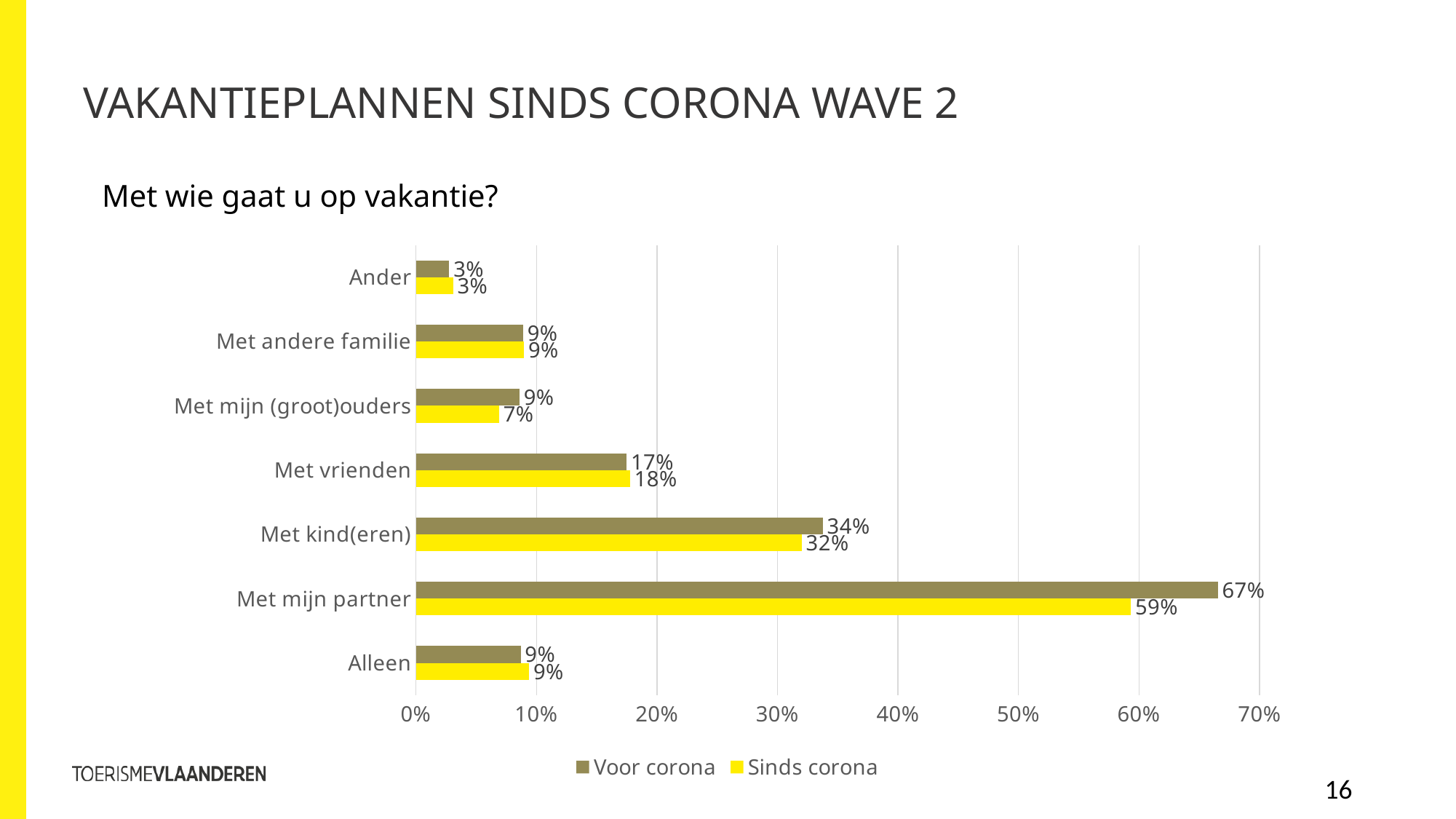
What is the difference between the 'Voor corona' and 'Sinds corona' values for 'Met mijn partner'? 8% What colour are the 'Sinds corona' bars? Yellow Which category has the highest value in the 'Sinds corona' series? Met mijn partner Which category has the lowest value in the 'Voor corona' series? Ander What is the value for 'Met kind(eren)' in the 'Sinds corona' series? 32% How many categories are shown on the chart? 7 What is the value for 'Met mijn partner' in the 'Voor corona' series? 67% What is the value for 'Met mijn (groot)ouders' in the 'Sinds corona' series? 7% What kind of chart is shown on the slide? Bar chart How many series does the legend list? 2 What is the value for 'Met vrienden' in the 'Voor corona' series? 17% Which is larger for 'Met vrienden': the 'Voor corona' value or the 'Sinds corona' value? Sinds corona